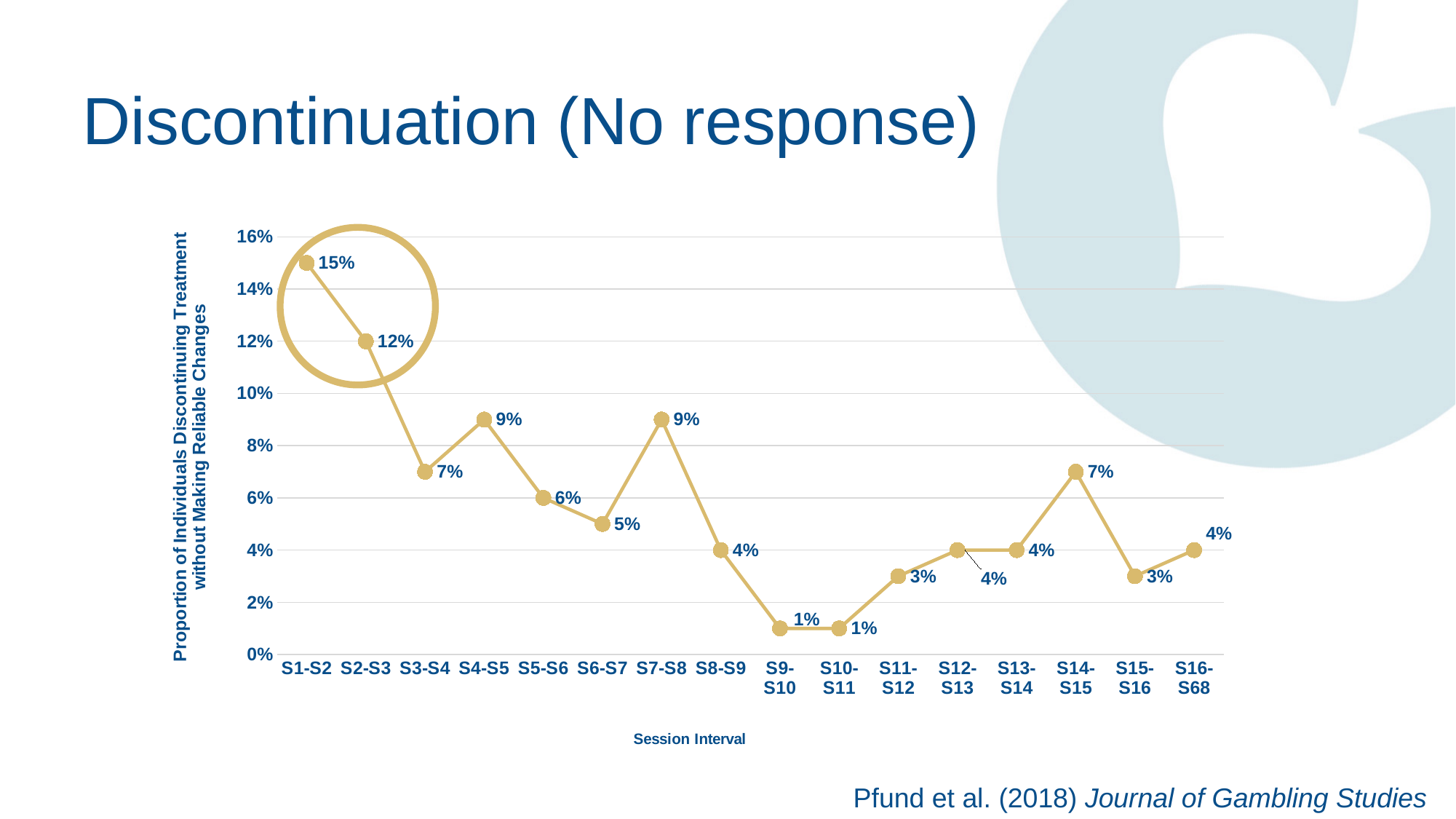
What kind of chart is shown on the slide? Line chart Which session interval has the highest proportion of individuals discontinuing treatment? S1-S2 What is the lowest value shown on the chart? 1% What is the value for the S14-S15 session interval? 7% What is the difference between the values for S7-S8 and S8-S9? 5% What is the difference between the values for S1-S2 and S2-S3? 3% How many session intervals are plotted on the chart? 16 Which is larger, the value for S4-S5 or the value for S5-S6? S4-S5 What is the value for the S1-S2 session interval? 15% What is the value for the S9-S10 session interval? 1% What is the value for the S2-S3 session interval? 12% What is the title of the x axis? Session Interval